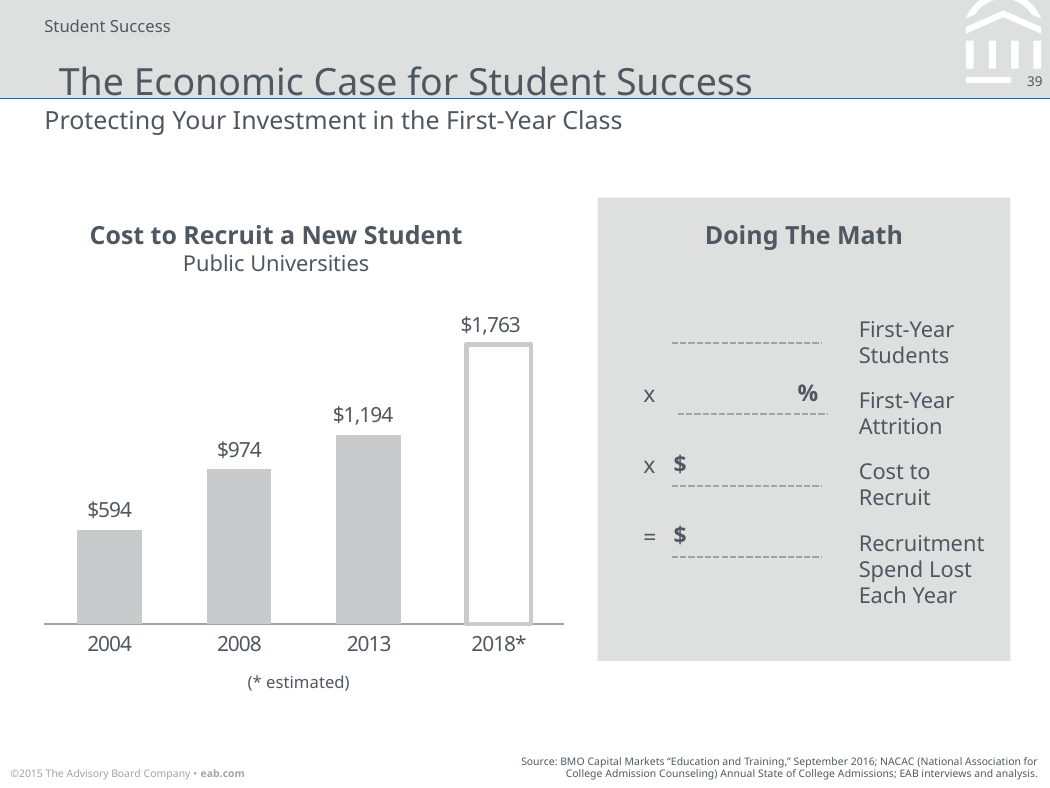
What is the difference between the cost to recruit in 2013 and in 2004? $600 Which year has the highest cost to recruit a new student? 2018* Does the cost to recruit a new student rise or fall from 2004 to 2018? Rise What is the cost to recruit a new student in 2004? $594 What type of chart is used to show the cost to recruit a new student? Bar chart What is the estimated cost to recruit a new student in 2018? $1,763 Which is larger, the cost to recruit in 2008 or in 2013? 2013 What is the cost to recruit a new student in 2013? $1,194 What is the cost to recruit a new student in 2008? $974 How many years are shown in the Cost to Recruit a New Student chart? 4 Which year has the lowest cost to recruit a new student? 2004 What is the difference between the estimated 2018 cost and the 2013 cost to recruit? $569